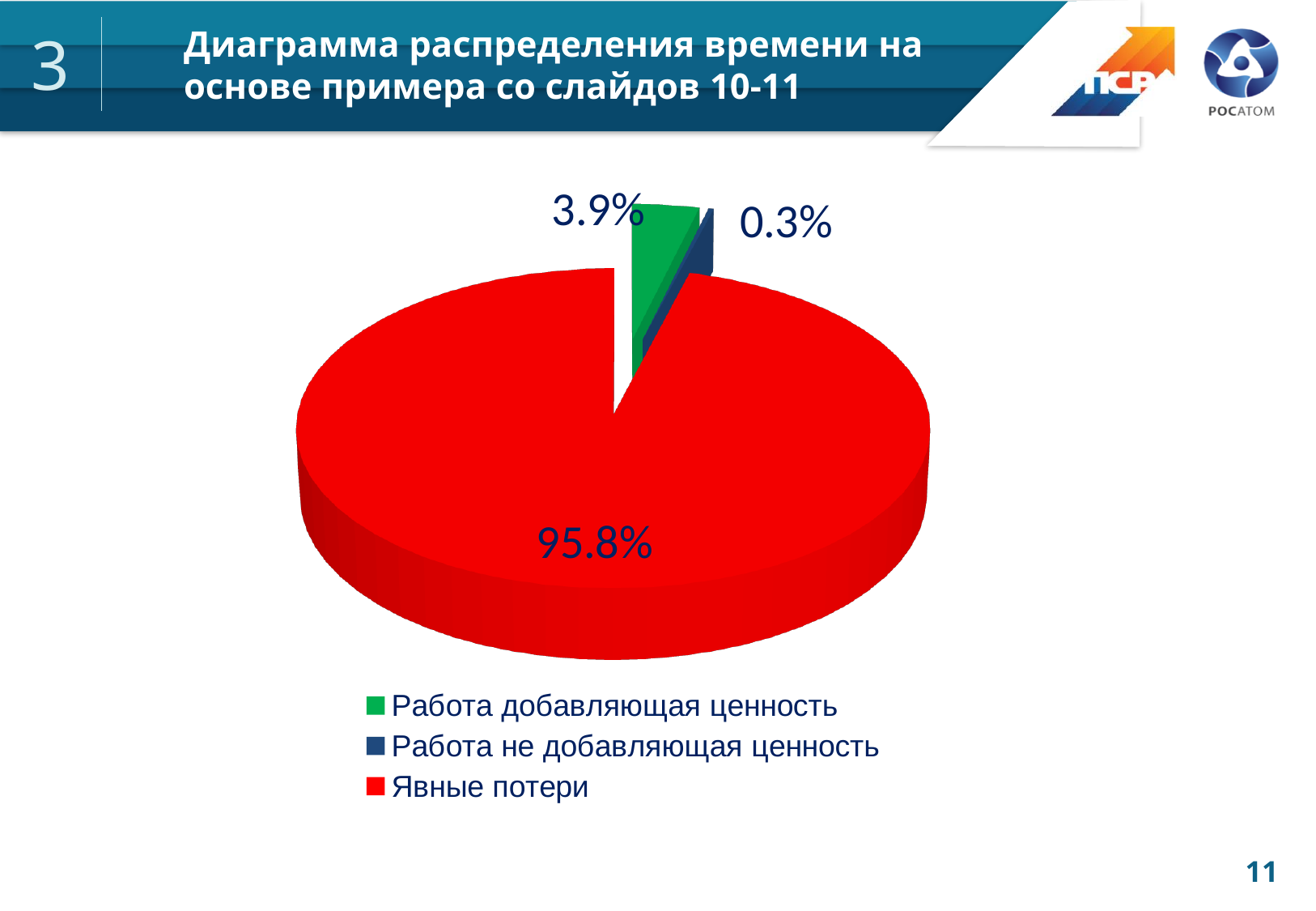
What share of the pie does "Работа не добавляющая ценность" take? 0.3% What share of the pie does "Явные потери" take? 95.8% What kind of chart is shown on the slide? pie chart How many entries does the legend list? 3 Which category has the smallest slice of the pie? Работа не добавляющая ценность How many slices does the pie chart have? 3 Which is larger: the share of "Работа добавляющая ценность" or "Работа не добавляющая ценность"? Работа добавляющая ценность What colour is the slice for "Работа добавляющая ценность"? green Which category has the largest slice of the pie? Явные потери What colour is the slice for "Явные потери"? red What share of the pie does "Работа добавляющая ценность" take? 3.9% What is the difference between the shares of "Явные потери" and "Работа добавляющая ценность"? 91.9%